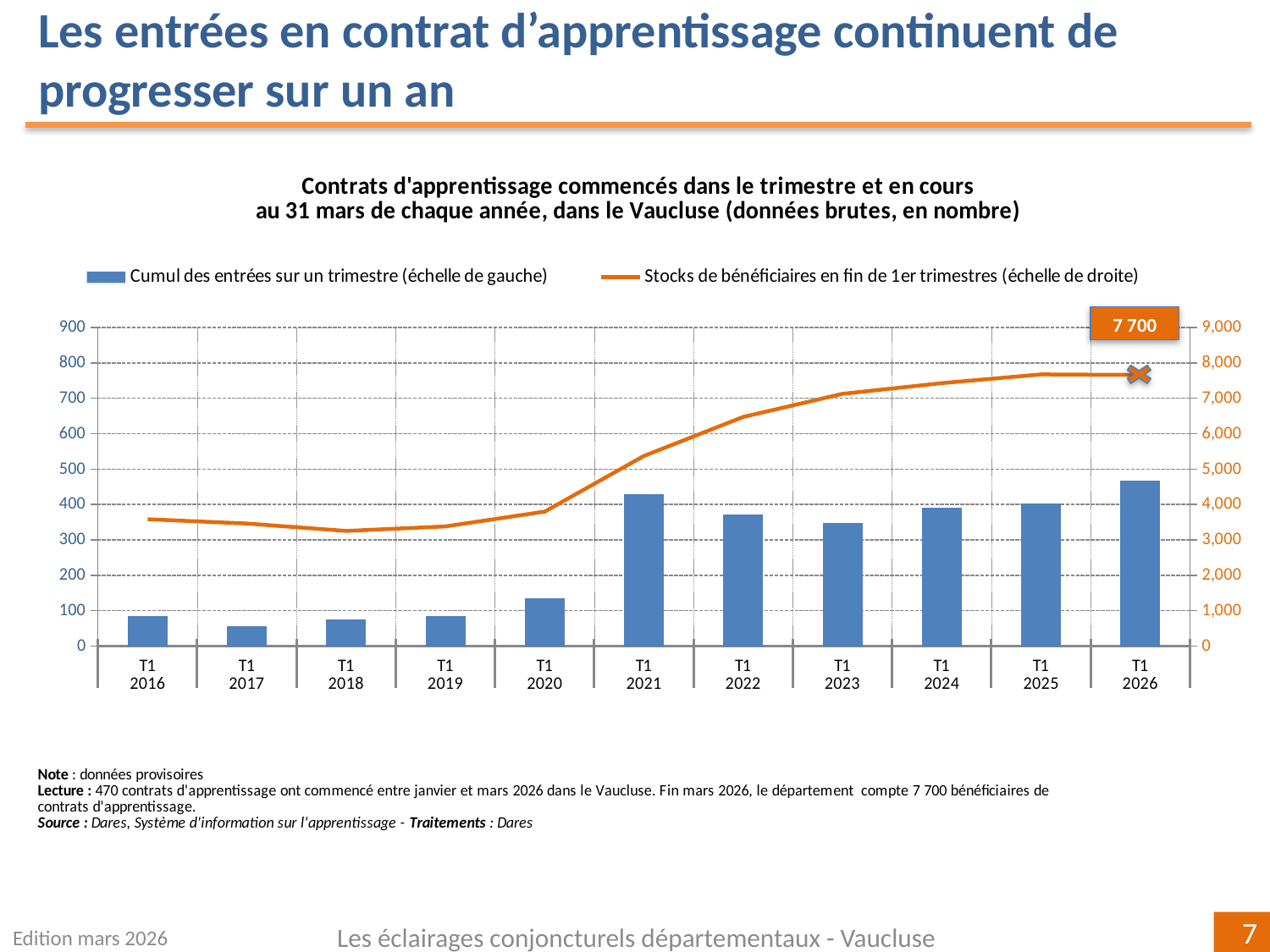
What colour is the line for Stocks de bénéficiaires en fin de 1er trimestres? Orange Which quarter has the highest bar for Cumul des entrées sur un trimestre? T1 2026 Is the bar value for T1 2020 greater or less than 100? greater Which bar is taller, T1 2022 or T1 2023? T1 2022 Does the stocks line rise or fall between T1 2020 and T1 2025? It rises How many quarters (categories) are shown on the x axis? 11 How many series does the legend list? 2 Is the bar value for T1 2021 greater or less than 400? greater Which quarter has the lowest bar for Cumul des entrées sur un trimestre? T1 2017 What is the value of the stocks of beneficiaries (Stocks de bénéficiaires en fin de 1er trimestres) at T1 2026? 7 700 Is the stocks line value at T1 2018 greater or less than 4,000? less What kind of chart is shown on the slide? A combined bar and line chart